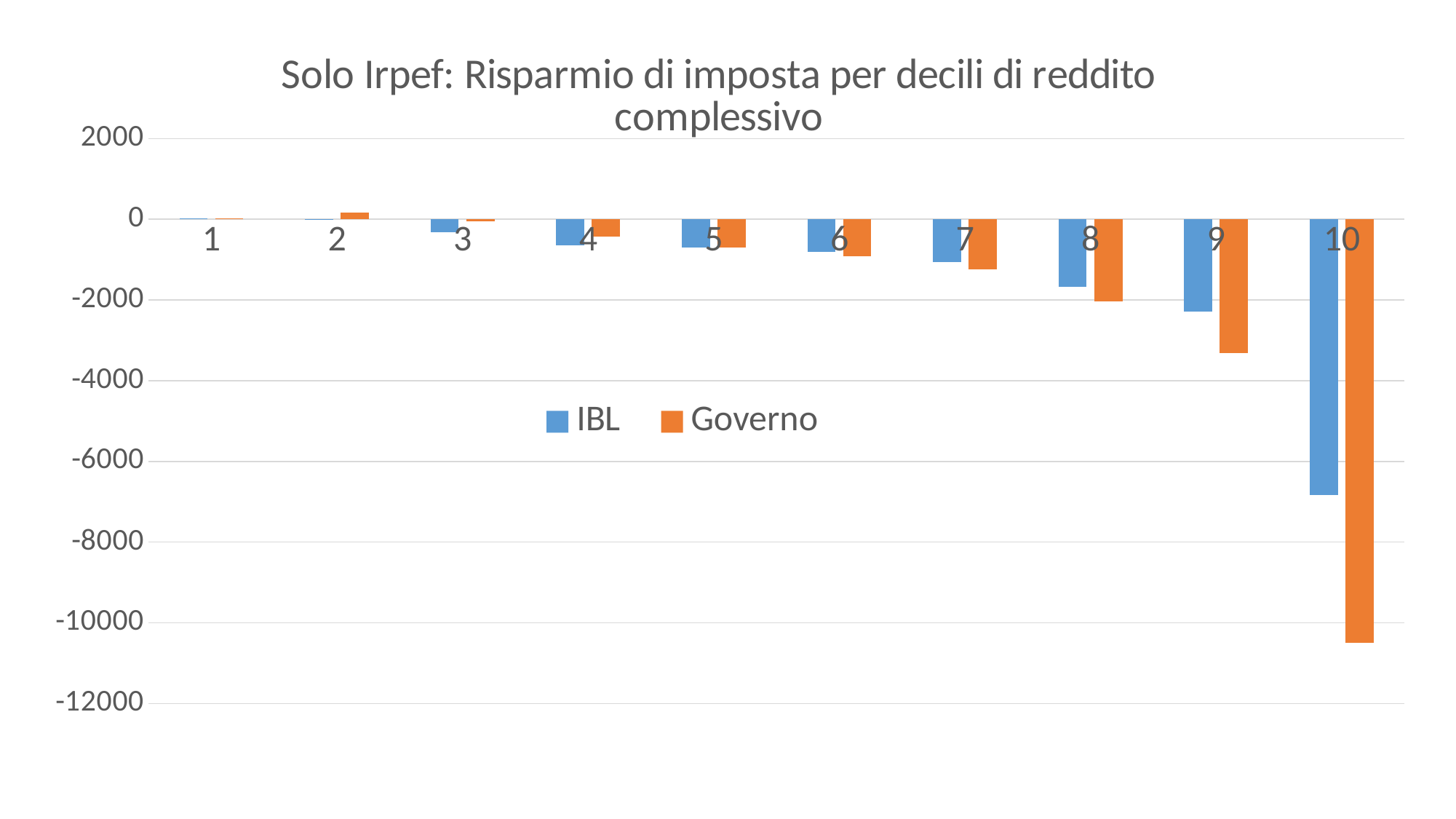
Do the values generally rise or fall as the decile number increases from 1 to 10? fall Is the IBL value for decile 10 greater or less than -6000? less For which decile does the IBL series reach its most negative value? 10 How many series does the legend list? 2 What kind of chart is shown on the slide? bar chart For decile 10, which series has the more negative value, IBL or Governo? Governo Is the Governo value for decile 10 greater or less than -10000? less Which series is shown in orange? Governo How many income deciles are plotted on the x axis? 10 For which decile does the Governo series reach its most negative value? 10 Is the Governo value for decile 9 greater or less than -4000? greater What is the title of the chart? Solo Irpef: Risparmio di imposta per decili di reddito complessivo